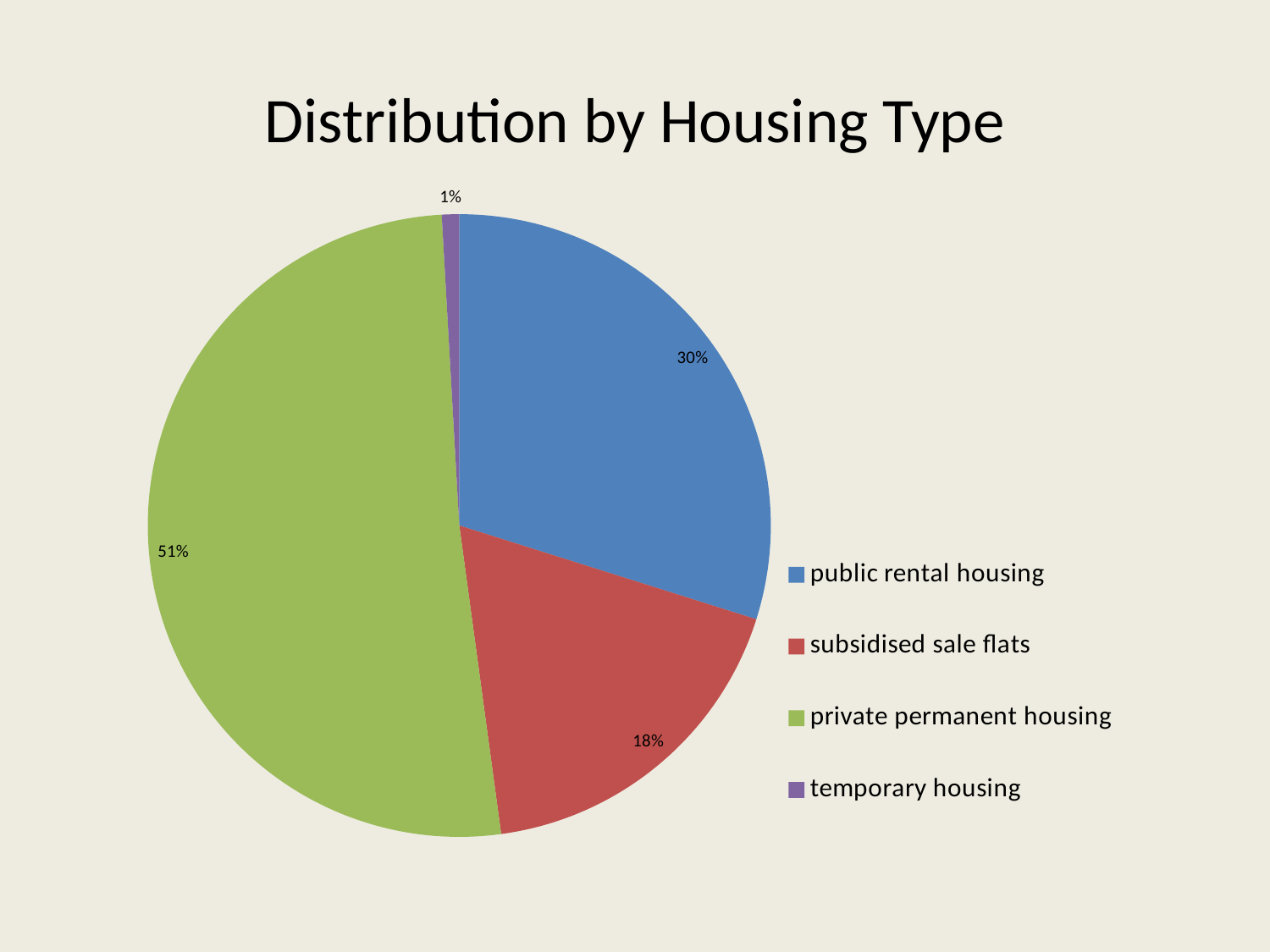
Which housing type has the smallest share of the pie? temporary housing What share of the pie is public rental housing? 30% What share of the pie is private permanent housing? 51% What colour is the slice for private permanent housing? green How many percentage points larger is the share of public rental housing than subsidised sale flats? 12 What share of the pie is temporary housing? 1% What is the title of the chart? Distribution by Housing Type Which is larger, the share of public rental housing or the share of subsidised sale flats? public rental housing How many categories does the legend list? 4 What type of chart is shown on the slide? pie chart Which housing type has the largest share of the pie? private permanent housing What share of the pie is subsidised sale flats? 18%